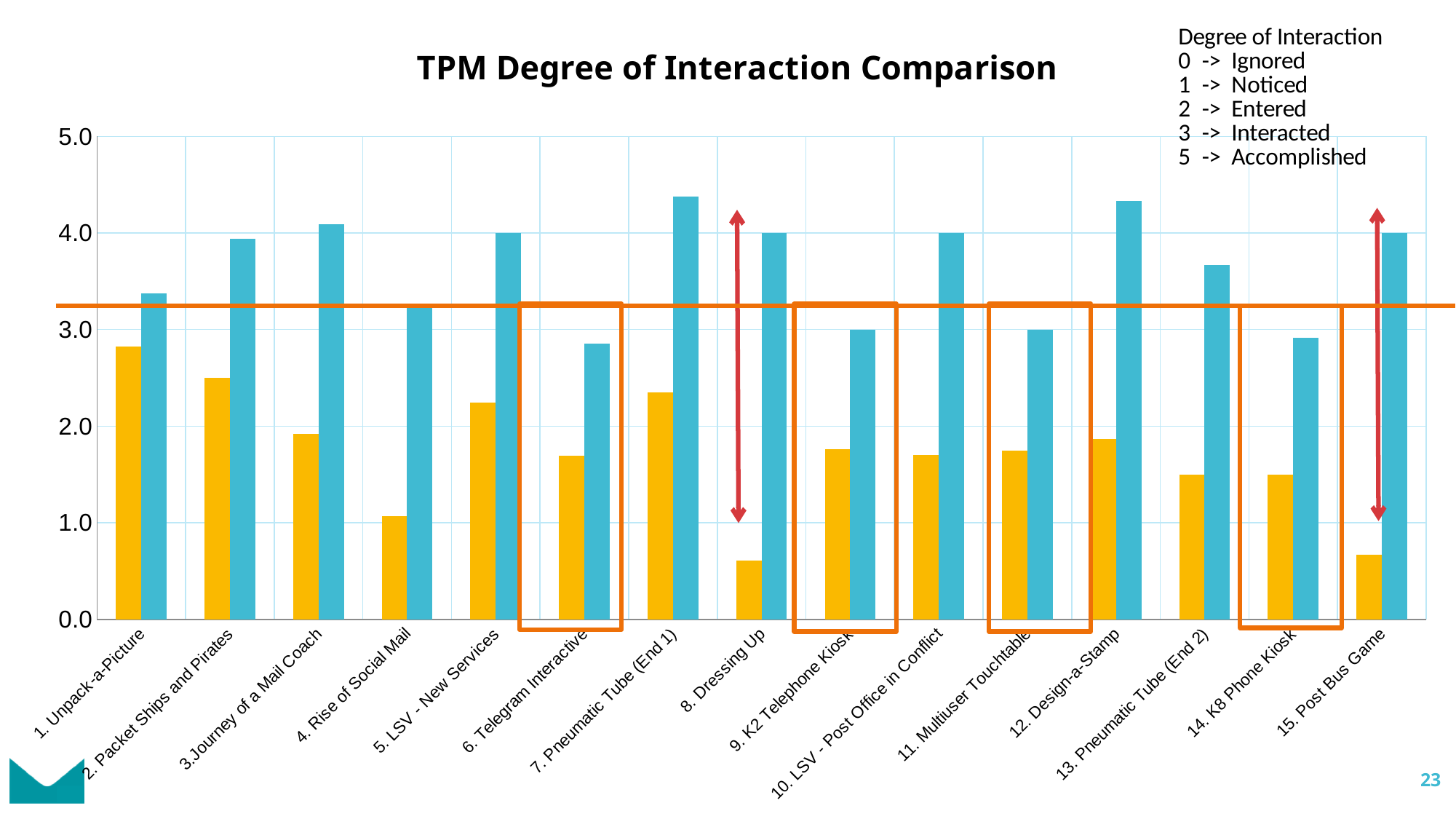
Is the blue bar for 13. Pneumatic Tube (End 2) greater or less than 3.0? greater Is the yellow bar for 4. Rise of Social Mail greater or less than 2.0? less Which category has the highest yellow bar? 1. Unpack-a-Picture What is the title of the chart? TPM Degree of Interaction Comparison Is the blue bar for 7. Pneumatic Tube (End 1) greater or less than 4.0? greater For 8. Dressing Up, which bar is larger, the yellow bar or the blue bar? the blue bar How many categories (exhibits) are shown along the x axis? 15 Which is larger, the yellow bar for 1. Unpack-a-Picture or the yellow bar for 4. Rise of Social Mail? 1. Unpack-a-Picture What kind of chart is shown on the slide? bar chart According to the Degree of Interaction key on the slide, what does a value of 5 mean? Accomplished